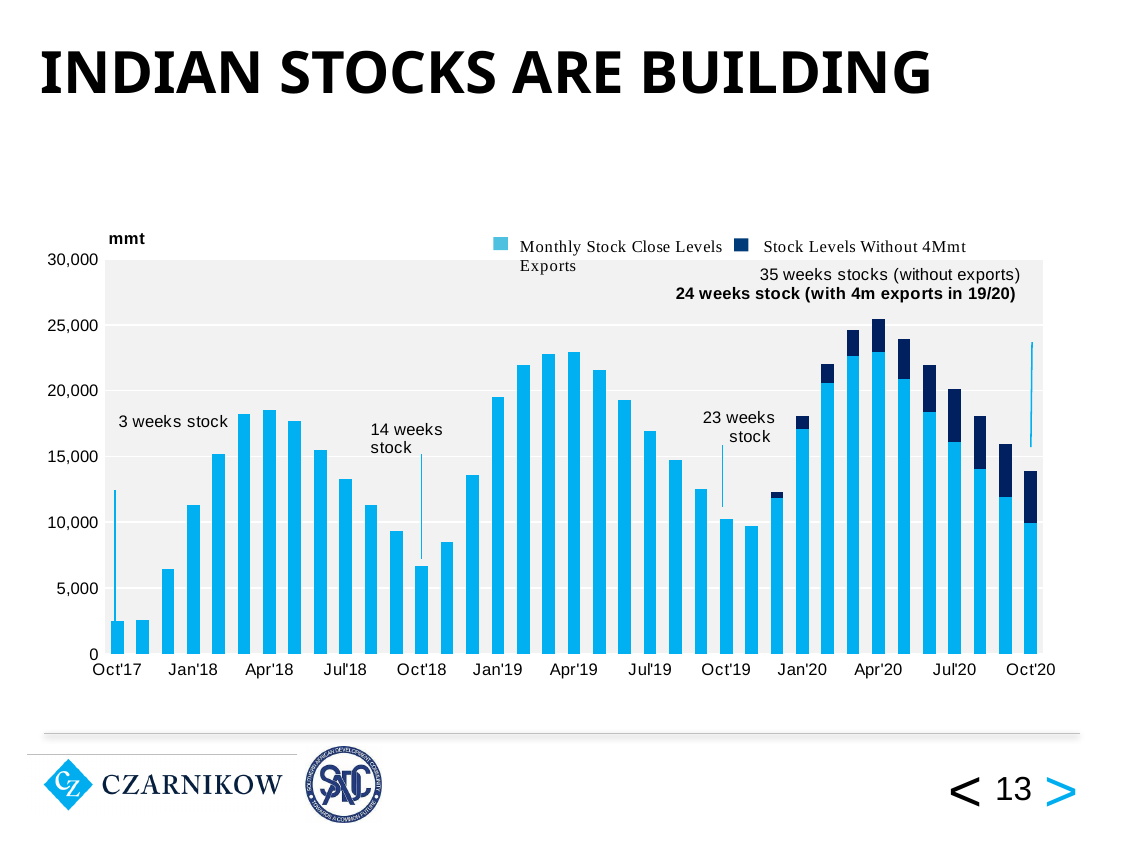
Is the total stacked value for Apr'20 greater or less than 20,000? greater Is the value for Jan'18 greater or less than 10,000? greater Is the value for Oct'17 greater or less than 5,000? less What is the title of the slide? INDIAN STOCKS ARE BUILDING Do the stock levels rise or fall from Oct'17 to Apr'18? rise What unit is shown at the top of the y axis? mmt How many series does the legend list? 2 What kind of chart is shown on the slide? Stacked bar chart Do the stock levels rise or fall from Apr'19 to Oct'19? fall